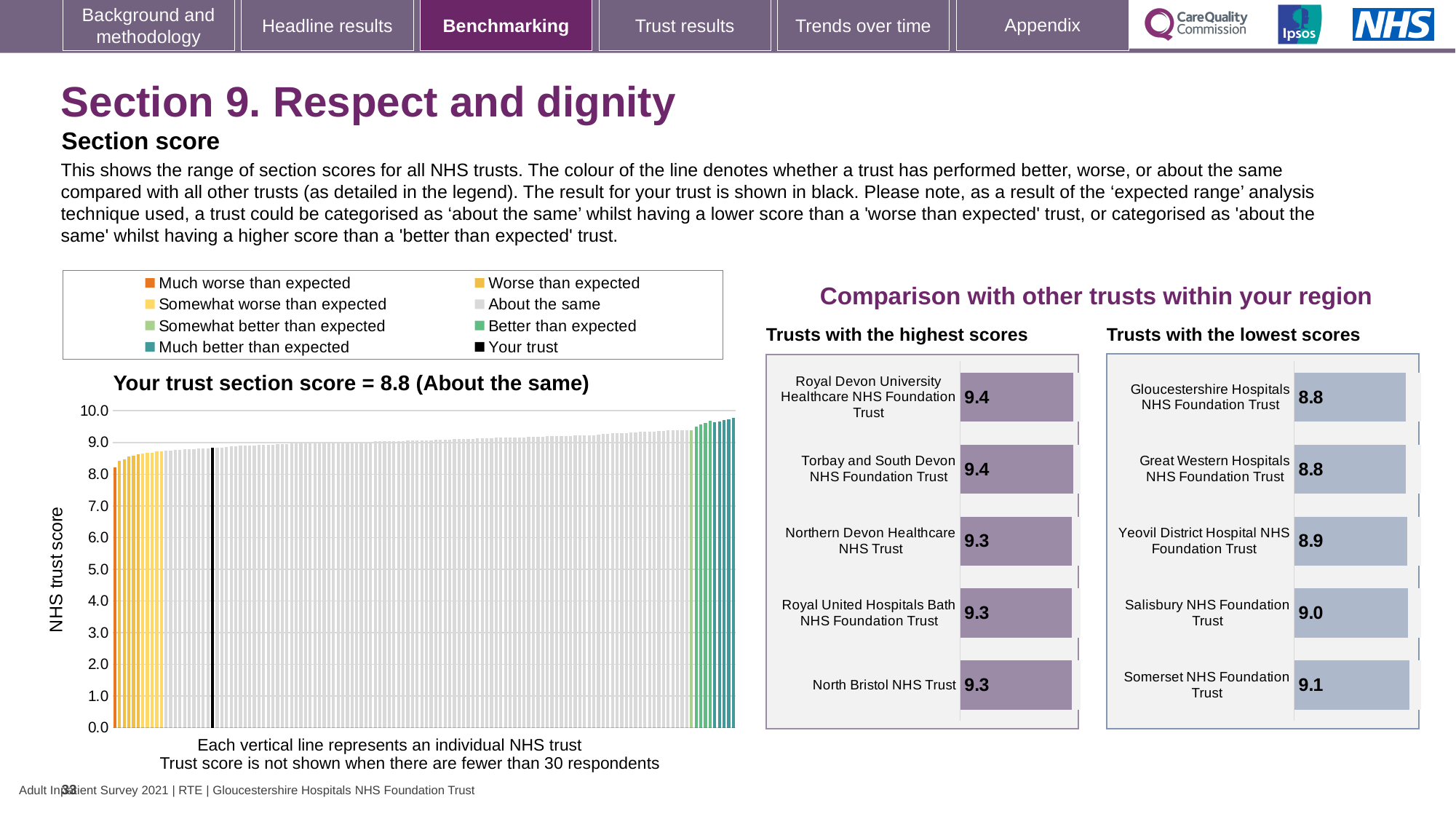
In the 'Trusts with the highest scores' chart, what is the difference between the scores of Royal Devon University Healthcare NHS Foundation Trust and North Bristol NHS Trust? 0.1 In the 'Trusts with the lowest scores' chart, what is the difference between the scores of Somerset NHS Foundation Trust and Gloucestershire Hospitals NHS Foundation Trust? 0.3 In the 'Trusts with the lowest scores' chart, which has the larger score, Yeovil District Hospital NHS Foundation Trust or Salisbury NHS Foundation Trust? Salisbury NHS Foundation Trust In the 'Your trust section score' chart, what kind of chart is shown? bar chart In the 'Your trust section score' chart, what is the label on the vertical axis? NHS trust score In the 'Your trust section score' chart, do the bars rise or fall from left to right? rise In the 'Your trust section score' chart, what is the section score for your trust? 8.8 In the 'Trusts with the lowest scores' chart, which trust has the highest score? Somerset NHS Foundation Trust In the 'Trusts with the highest scores' chart, what is the score for Northern Devon Healthcare NHS Trust? 9.3 In the 'Your trust section score' chart, is the value of the leftmost bar greater or less than 9.0? less In the 'Trusts with the highest scores' chart, how many trusts are listed? 5 In the 'Your trust section score' chart, how many entries does the legend list? 8